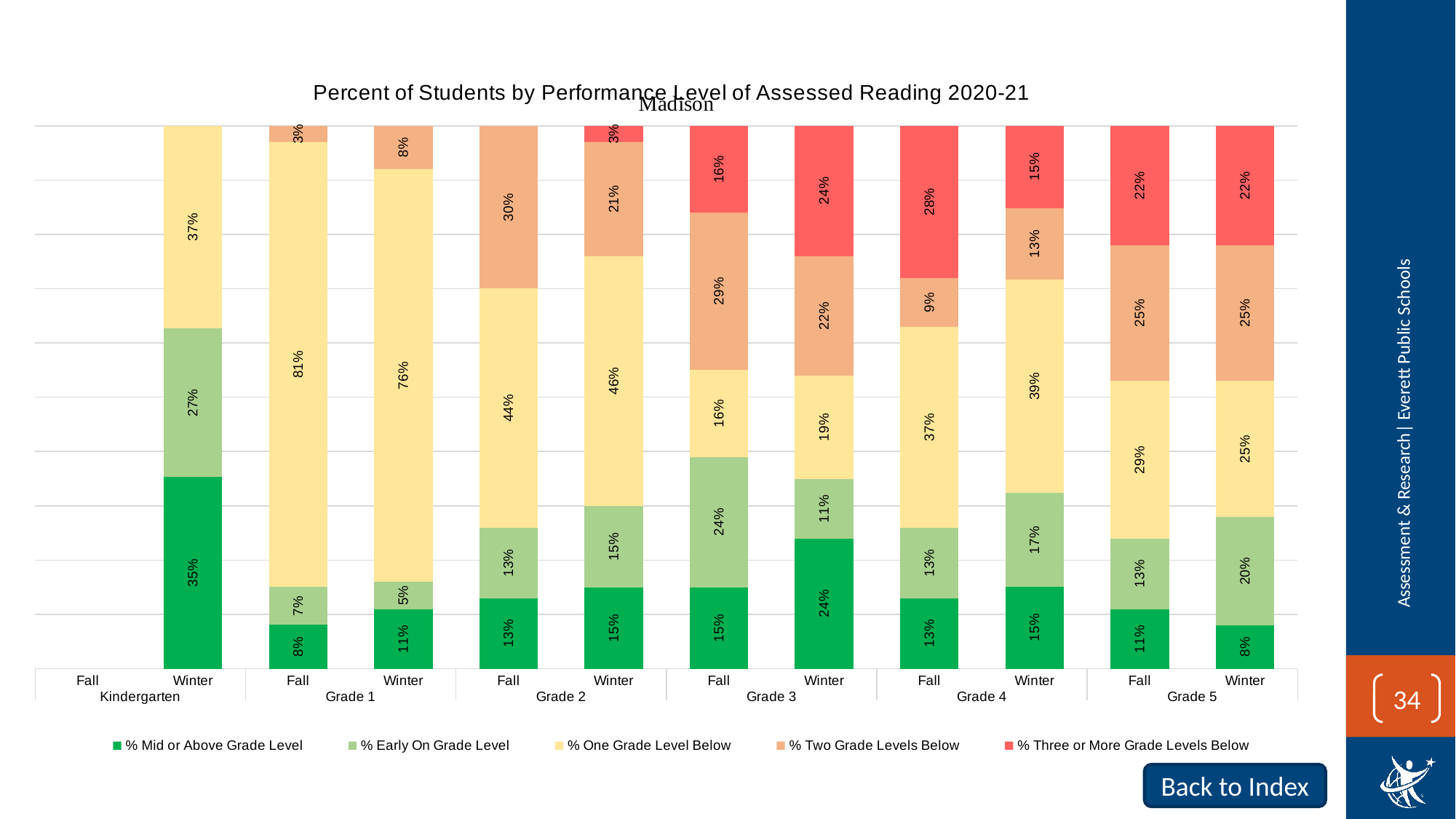
Which bar has the highest % Mid or Above Grade Level value? Kindergarten Winter What percentage of Kindergarten Winter students are at Mid or Above Grade Level? 35% What is the % Two Grade Levels Below value for Grade 2 Fall? 30% Which bar has the highest % One Grade Level Below value? Grade 1 Fall What is the % One Grade Level Below value for Grade 1 Fall? 81% Does the % Mid or Above Grade Level rise or fall from Grade 5 Fall to Grade 5 Winter? Fall How many series does the legend list? 5 What kind of chart is shown on the slide? Stacked bar chart What is the difference in % One Grade Level Below between Grade 1 Fall and Grade 1 Winter? 5 percentage points What percentage of Grade 4 Fall students are Three or More Grade Levels Below? 28% Which is larger, the % Mid or Above Grade Level for Grade 3 Fall or for Grade 3 Winter? Grade 3 Winter What colour represents % Three or More Grade Levels Below in the legend? Red